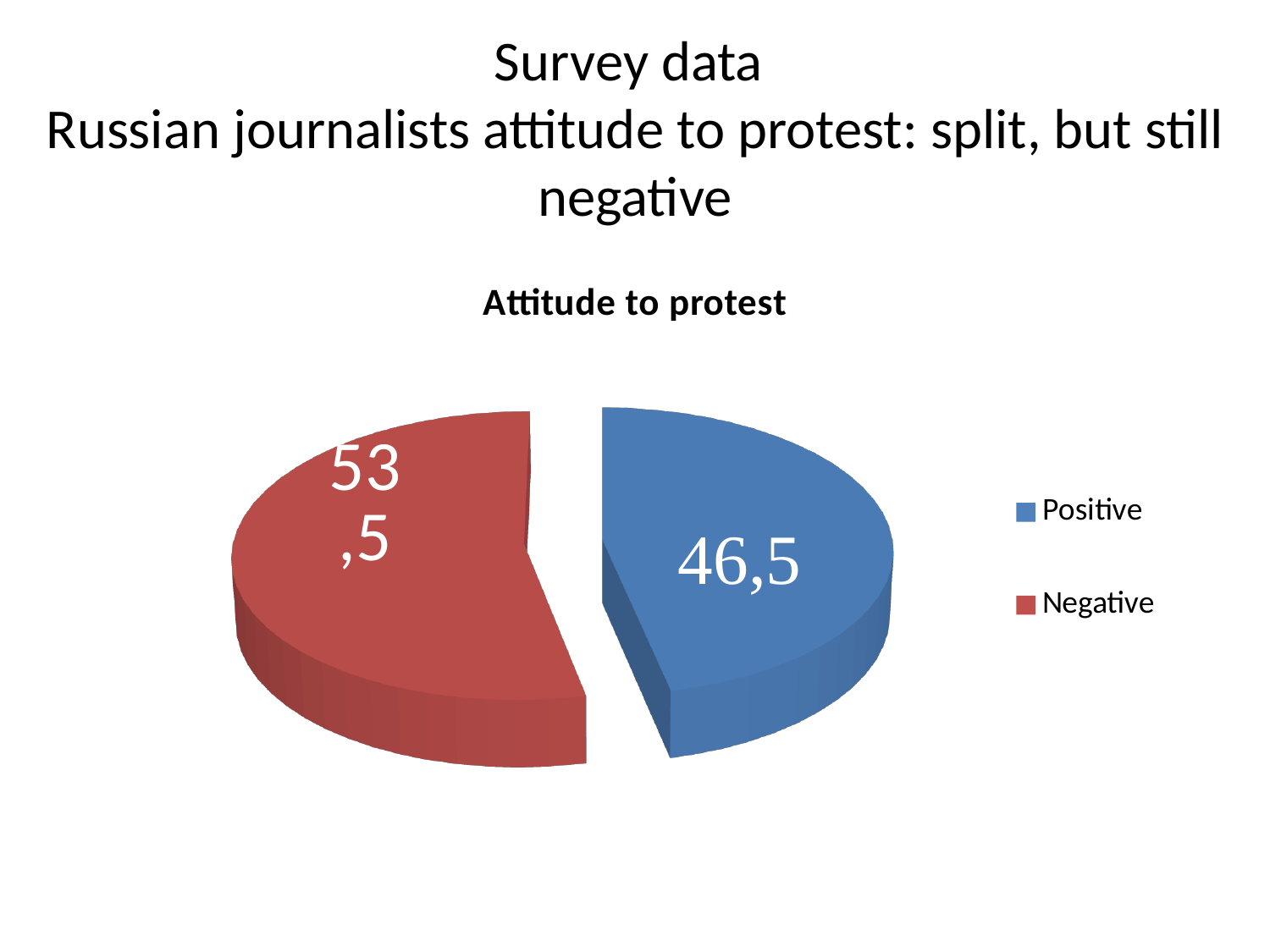
Which category has the smallest slice in the Attitude to protest chart? Positive What is the difference between the Negative and Positive values in the Attitude to protest chart? 7 What colour is the Negative slice in the Attitude to protest chart? Red What kind of chart is shown on the slide? Pie chart What is the value for Positive in the Attitude to protest chart? 46,5 How many entries does the legend of the Attitude to protest chart list? 2 What is the title of the chart on the slide? Attitude to protest How many slices does the Attitude to protest pie chart have? 2 Which category has the largest slice in the Attitude to protest chart? Negative Which is larger in the Attitude to protest chart, Positive or Negative? Negative What is the value for Negative in the Attitude to protest chart? 53,5